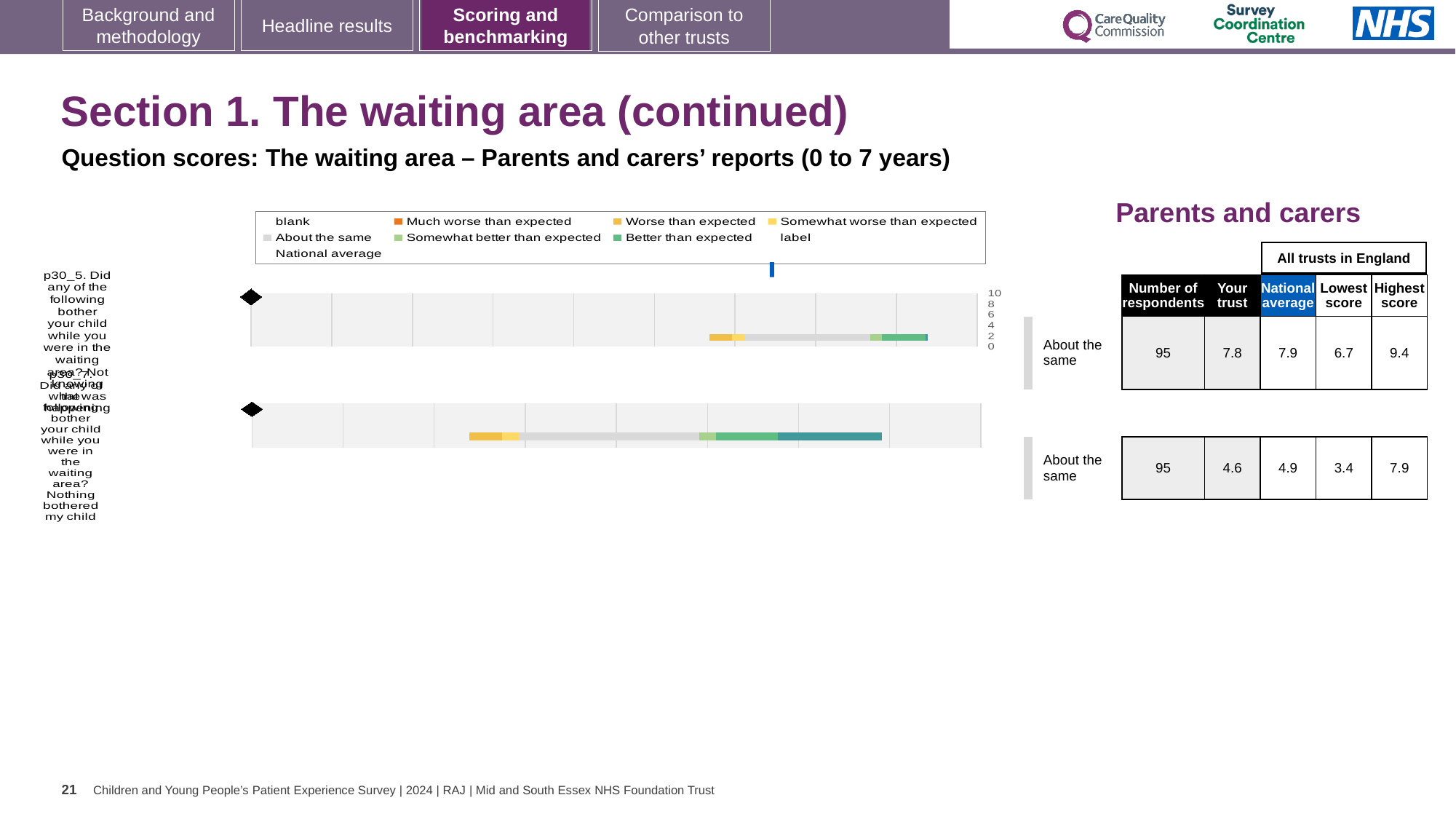
What kind of chart is used on this slide to show the question scores for the waiting area? bar chart For the top chart (p30_5), which is larger: the 'Your trust' score or the national average? National average What benchmarking category is shown next to both charts on this slide? About the same How many question rows (charts) are plotted on this slide? 2 For the top chart (p30_5, Not knowing what was happening), what is the 'Your trust' score shown in the table? 7.8 For the bottom chart (p30_7), what is the lowest score among all trusts in England? 3.4 For the bottom chart (p30_7, Nothing bothered my child), what is the national average score? 4.9 For the top chart (p30_5), what is the highest score among all trusts in England? 9.4 For the bottom chart (p30_7, Nothing bothered my child), what is the 'Your trust' score? 4.6 For the top chart (p30_5), what is the difference between the highest score (9.4) and the lowest score (6.7) across all trusts in England? 2.7 For the top chart (p30_5, Not knowing what was happening), what is the national average score? 7.9 How many respondents are shown for the bottom chart (p30_7, Nothing bothered my child)? 95